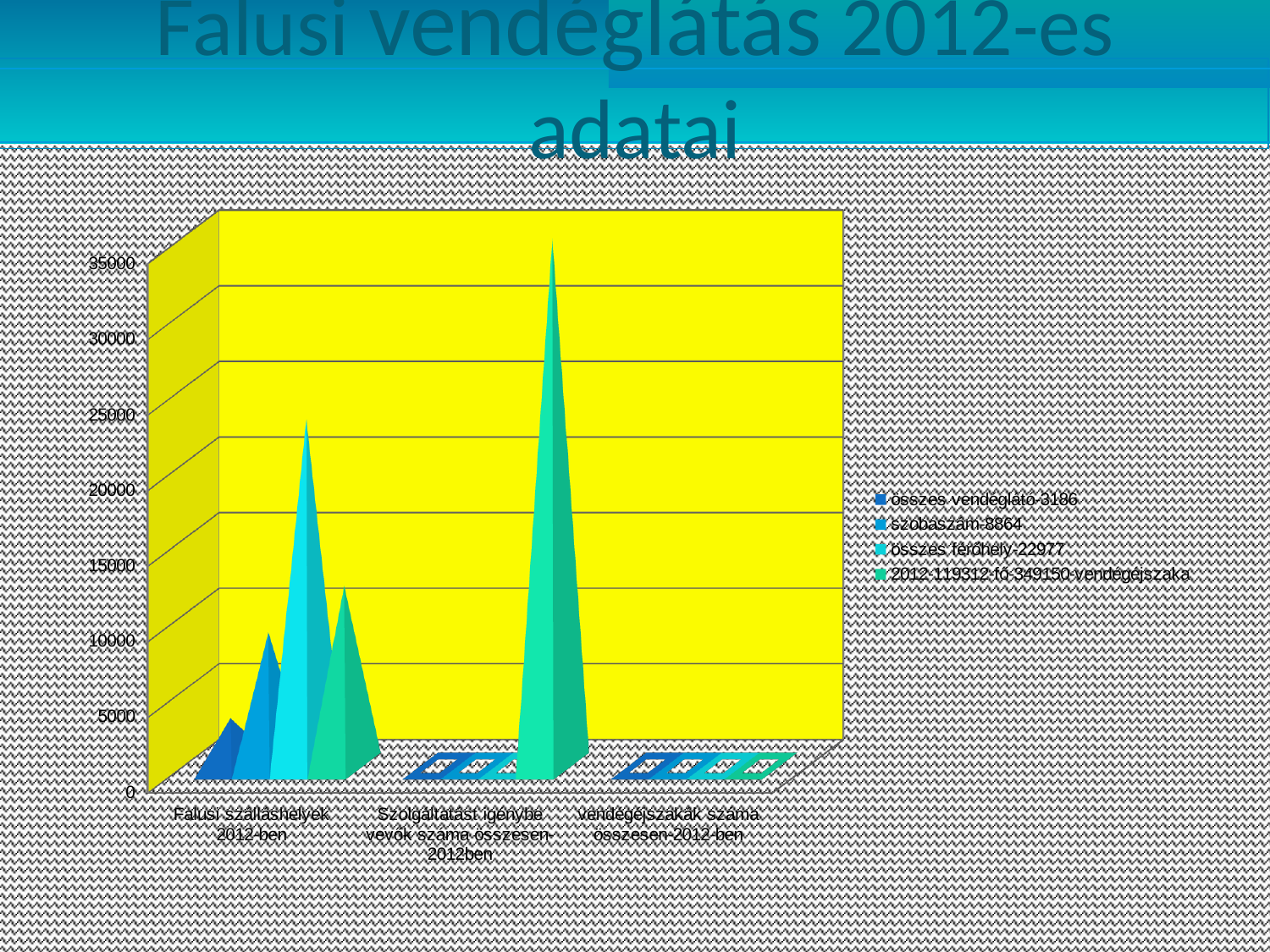
In the 'Falusi szálláshelyek 2012-ben' category, is the value for 'összes férőhely' greater or less than 20000? greater Which series has the lowest value in the 'Falusi szálláshelyek 2012-ben' category? összes vendéglátó-3186 How many series does the chart's legend list? 4 What is the first entry in the chart's legend? összes vendéglátó-3186 In the 'Falusi szálláshelyek 2012-ben' category, which is larger: the value for 'szobaszám' or the value for 'összes vendéglátó'? szobaszám How many categories are shown on the x axis of the chart? 3 What is the title of the chart? Falusi vendéglátás 2012-es adatai What kind of chart is shown on the slide? bar chart In the 'Szolgáltatást igénybe vevők száma összesen-2012ben' category, is the value for the '2012-119312-fő-349150-vendégéjszaka' series greater or less than 30000? greater Which series has the highest value in the 'Falusi szálláshelyek 2012-ben' category? összes férőhely-22977